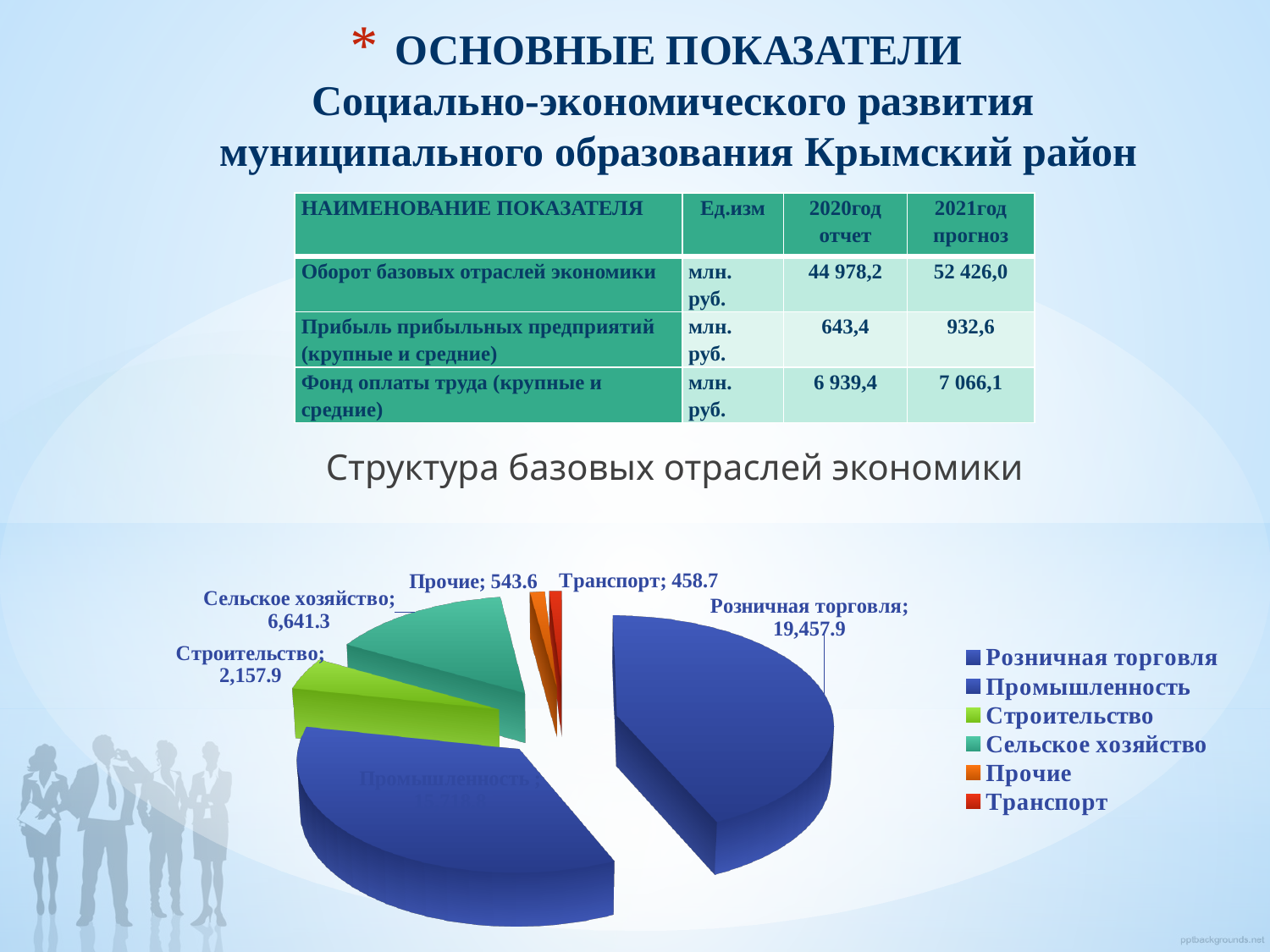
In the pie chart, what is the difference between the values for Сельское хозяйство and Строительство? 4,483.4 In the pie chart, which is larger: Сельское хозяйство or Строительство? Сельское хозяйство In the pie chart, what is the value for Розничная торговля? 19,457.9 In the pie chart, what is the value for Сельское хозяйство? 6,641.3 Which category has the smallest slice in the pie chart? Транспорт In the pie chart, what is the value for Прочие? 543.6 In the pie chart, what is the value for Транспорт? 458.7 In the pie chart, what is the value for Строительство? 2,157.9 In the pie chart, what is the difference between the values for Прочие and Транспорт? 84.9 Which colour represents Строительство in the pie chart? green What kind of chart is shown under the heading "Структура базовых отраслей экономики"? pie chart How many categories does the legend of the pie chart list? 6